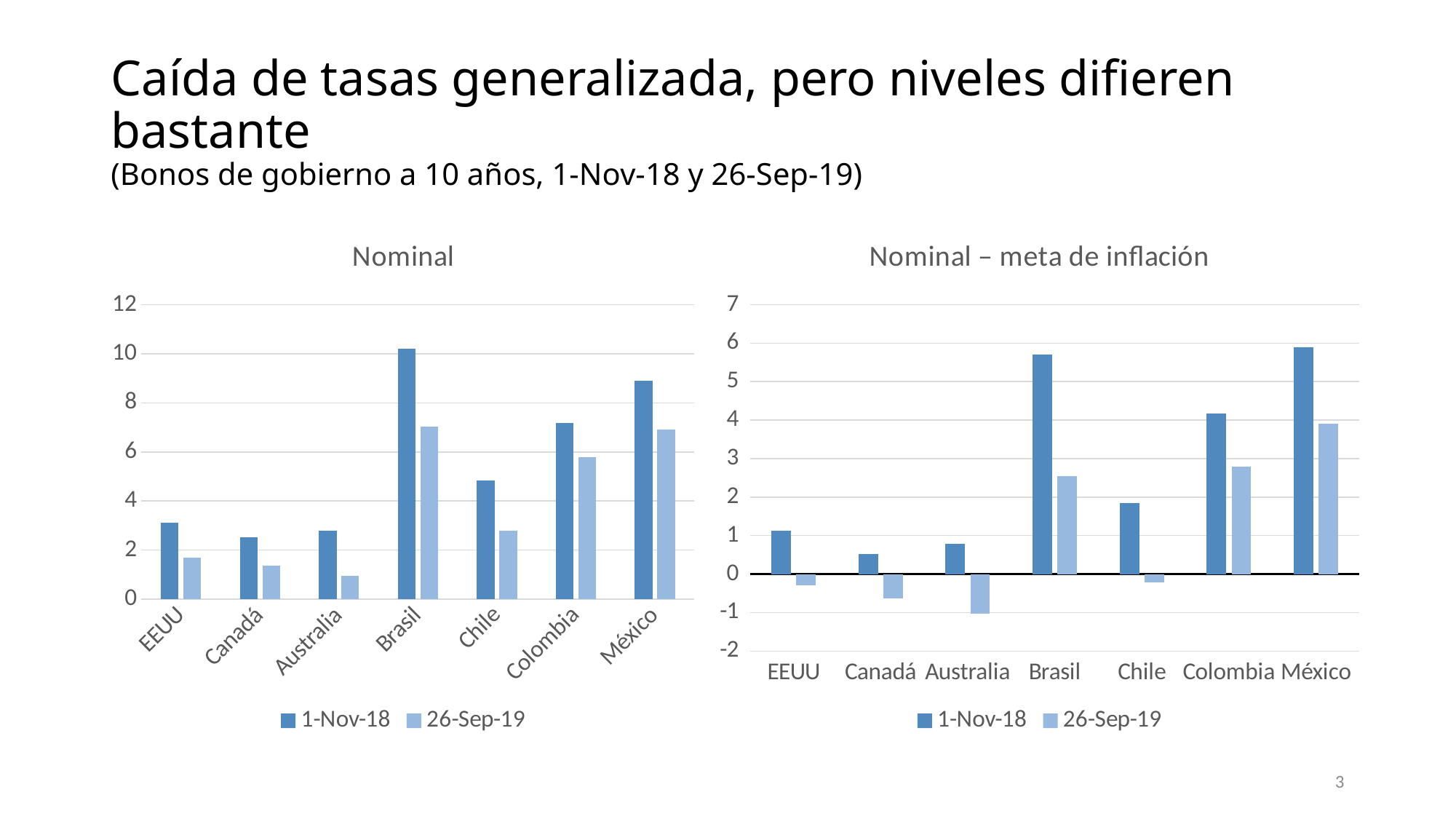
In the 'Nominal' chart, is the 26-Sep-19 value for Chile greater or less than 4? less In the 'Nominal – meta de inflación' chart, which country has the lowest 26-Sep-19 value? Australia In the 'Nominal' chart, which country has the lowest 26-Sep-19 value? Australia What type of chart is the 'Nominal' chart on the left? bar chart In the 'Nominal – meta de inflación' chart, which country has the highest 26-Sep-19 value? México In the 'Nominal' chart, is the 1-Nov-18 value for Brasil greater or less than 10? greater In the 'Nominal' chart, which country has the highest 1-Nov-18 value? Brasil In the 'Nominal – meta de inflación' chart, is the 26-Sep-19 value for Canadá greater or less than 0? less What are the two legend entries of the 'Nominal – meta de inflación' chart? 1-Nov-18 and 26-Sep-19 How many countries are shown on the x axis of the 'Nominal – meta de inflación' chart? 7 How many series does the legend of the 'Nominal' chart list? 2 In the 'Nominal' chart, which is larger for Colombia: the 1-Nov-18 value or the 26-Sep-19 value? 1-Nov-18